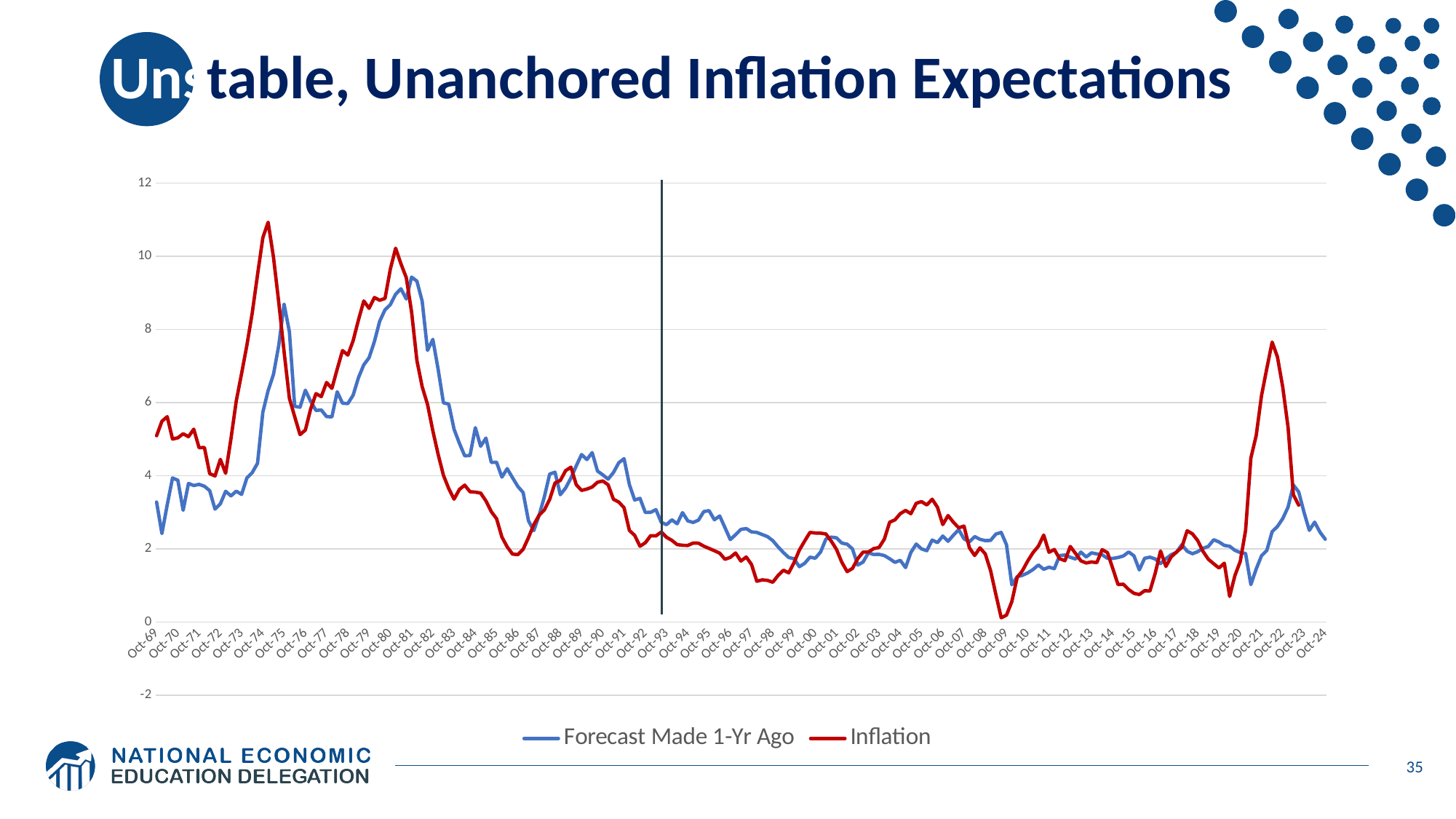
Between Oct-81 and Oct-86, does the Inflation series generally rise or fall? fall Around which x-axis label does the Inflation series reach its highest value? Oct-74 How many series does the legend list? 2 Is the Inflation value at Oct-09 greater or less than 2? less What colour is the Inflation line? red Is the Inflation value at Oct-74 greater or less than 10? greater Is the Forecast Made 1-Yr Ago value at Oct-81 greater or less than 8? greater What kind of chart is shown on the slide? line chart At Oct-74, which series has the higher value, Forecast Made 1-Yr Ago or Inflation? Inflation Around which x-axis label does the Inflation series reach its lowest value? Oct-09 At Oct-21, which series has the higher value, Forecast Made 1-Yr Ago or Inflation? Inflation What are the two series named in the legend? Forecast Made 1-Yr Ago and Inflation